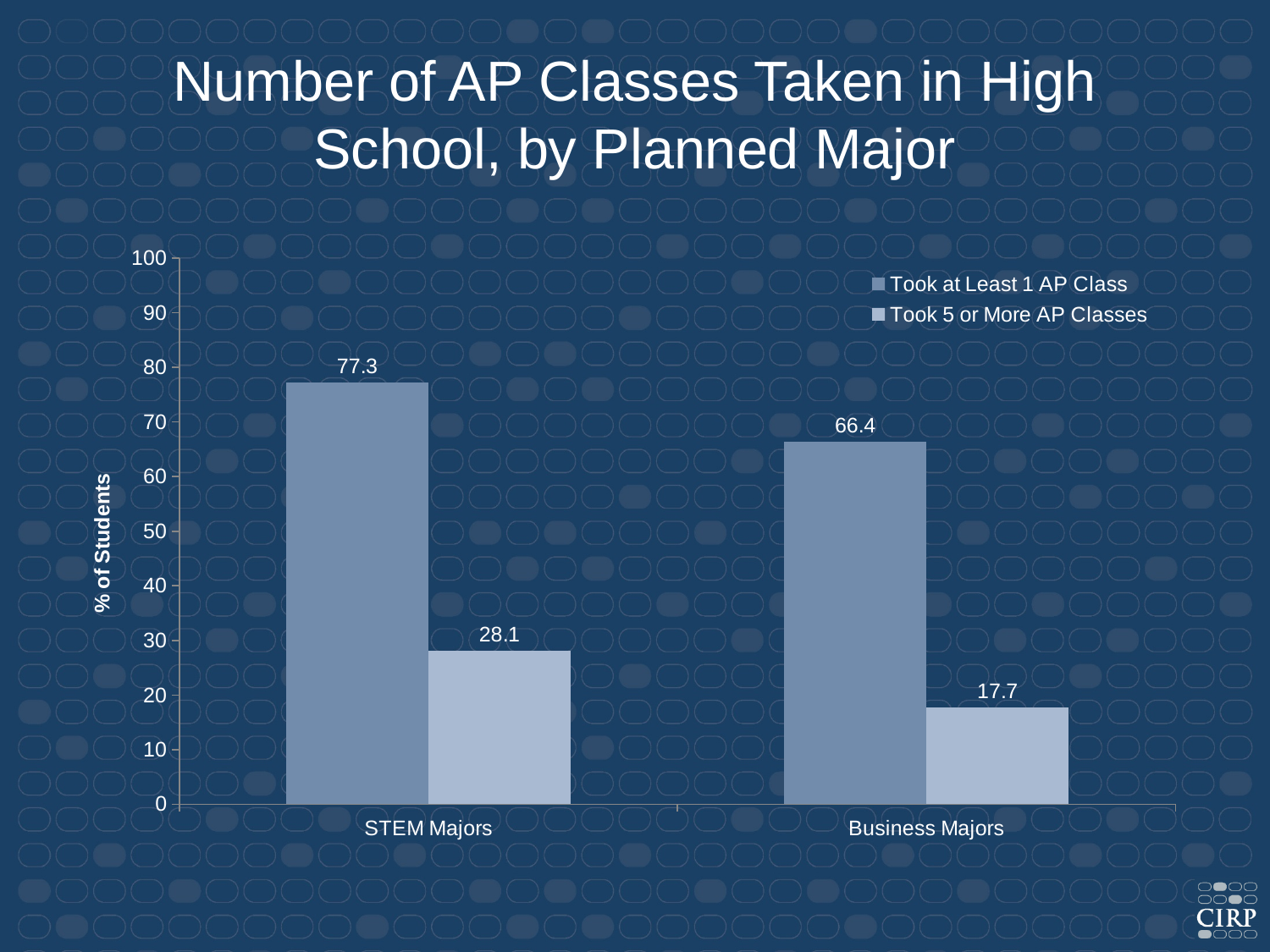
How many major categories are shown on the x axis? 2 What is the difference between STEM Majors and Business Majors for 'Took 5 or More AP Classes'? 10.4 What percentage of Business Majors took at least 1 AP class? 66.4 How many series does the legend list? 2 Which bar on the chart is the lowest? Business Majors, Took 5 or More AP Classes Which group has the higher value for 'Took at Least 1 AP Class', STEM Majors or Business Majors? STEM Majors What percentage of STEM Majors took at least 1 AP class? 77.3 What is the label of the y axis? % of Students What percentage of Business Majors took 5 or more AP classes? 17.7 What is the difference between 'Took at Least 1 AP Class' and 'Took 5 or More AP Classes' for STEM Majors? 49.2 What kind of chart is shown on the slide? Bar chart What percentage of STEM Majors took 5 or more AP classes? 28.1